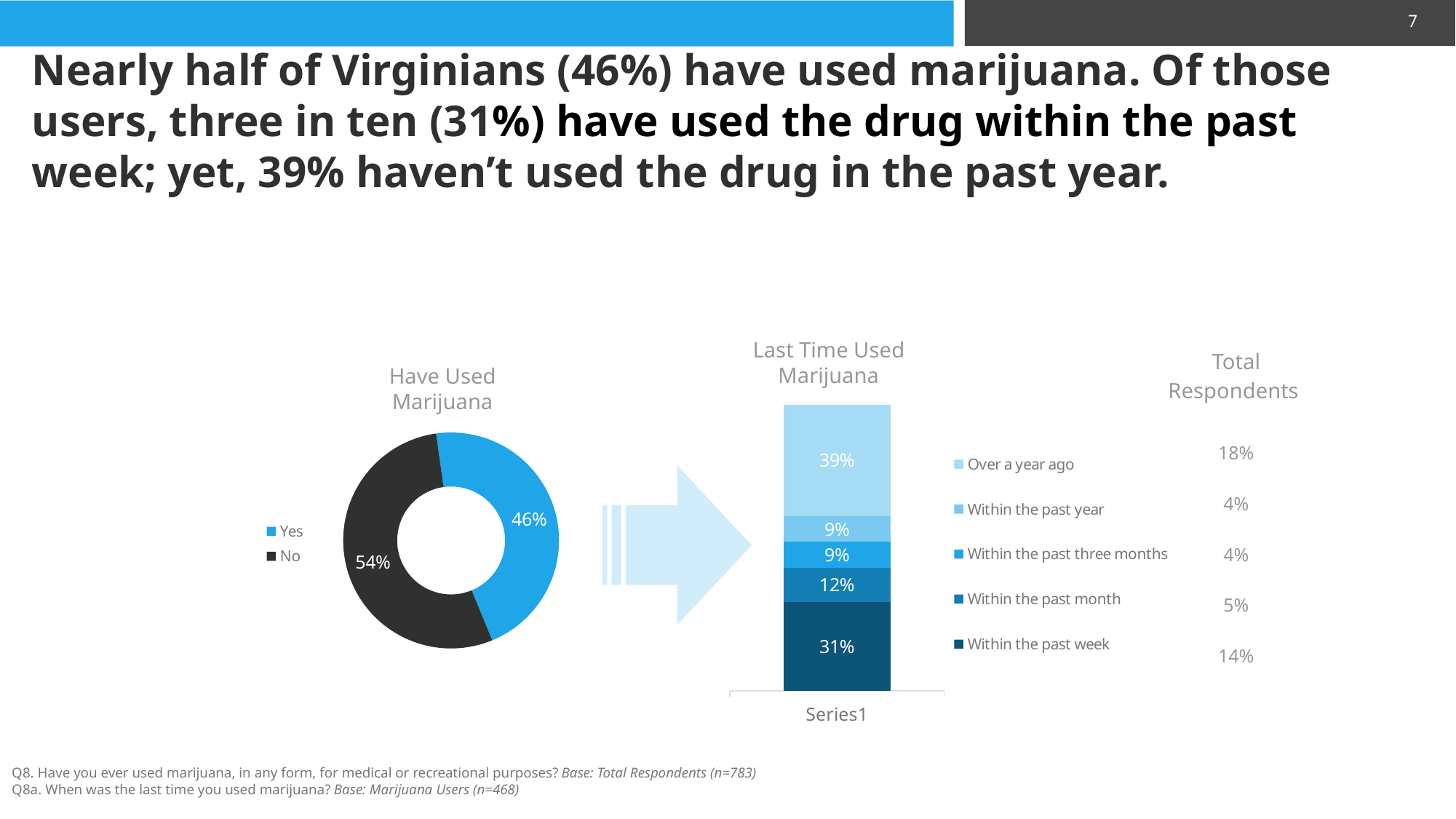
In the "Have Used Marijuana" chart, which response has the larger share, Yes or No? No In the "Last Time Used Marijuana" chart, which category has the largest share? Over a year ago In the "Have Used Marijuana" chart, what is the difference between the No and Yes shares? 8% What kind of chart is the "Have Used Marijuana" chart? Donut (pie) chart In the "Have Used Marijuana" chart, what percentage of respondents answered Yes? 46% In the "Last Time Used Marijuana" chart, what percentage of users last used marijuana over a year ago? 39% In the "Last Time Used Marijuana" chart, how many categories does the legend list? 5 In the "Last Time Used Marijuana" chart, what percentage of users last used marijuana within the past week? 31% In the "Have Used Marijuana" chart, what percentage of respondents answered No? 54% In the "Last Time Used Marijuana" chart, what percentage of users last used marijuana within the past month? 12% What kind of chart is the "Last Time Used Marijuana" chart? Stacked bar chart In the "Last Time Used Marijuana" chart, what is the difference between the "Over a year ago" and "Within the past week" shares? 8%